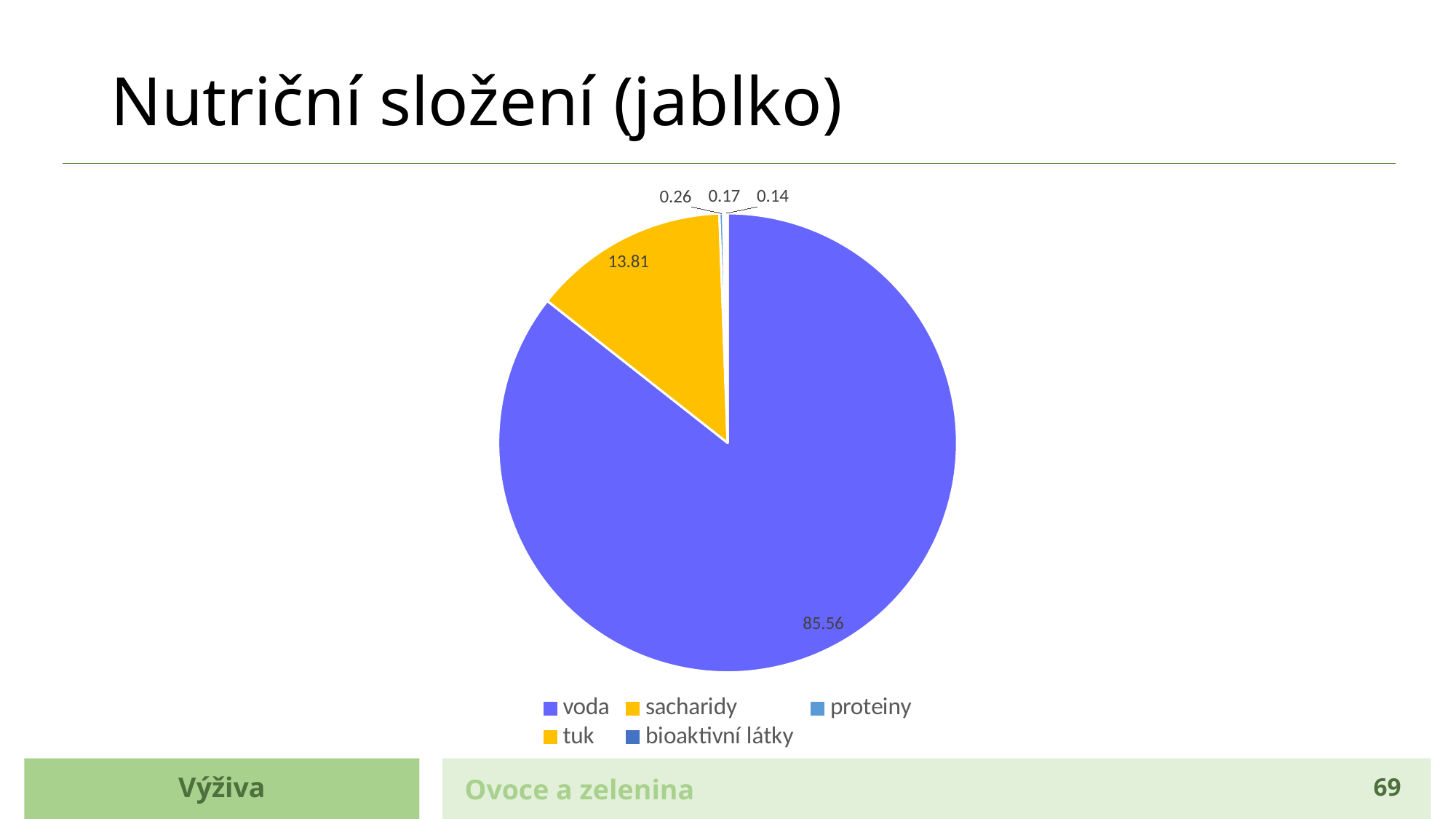
What is the smallest value labelled on the pie chart? 0.14 What kind of chart is shown on the slide? pie chart How many categories does the legend of the pie chart list? 5 What do the five labelled values on the pie chart add up to? 99.94 What is the title of the slide containing the pie chart? Nutriční složení (jablko) What is the value shown for sacharidy in the pie chart? 13.81 What colour is the sacharidy slice in the pie chart? yellow What is the value shown for voda in the pie chart? 85.56 Which category has the largest slice of the pie chart? voda Which is larger, the value for voda or the value for sacharidy? voda What is the difference between the values for voda and sacharidy? 71.75